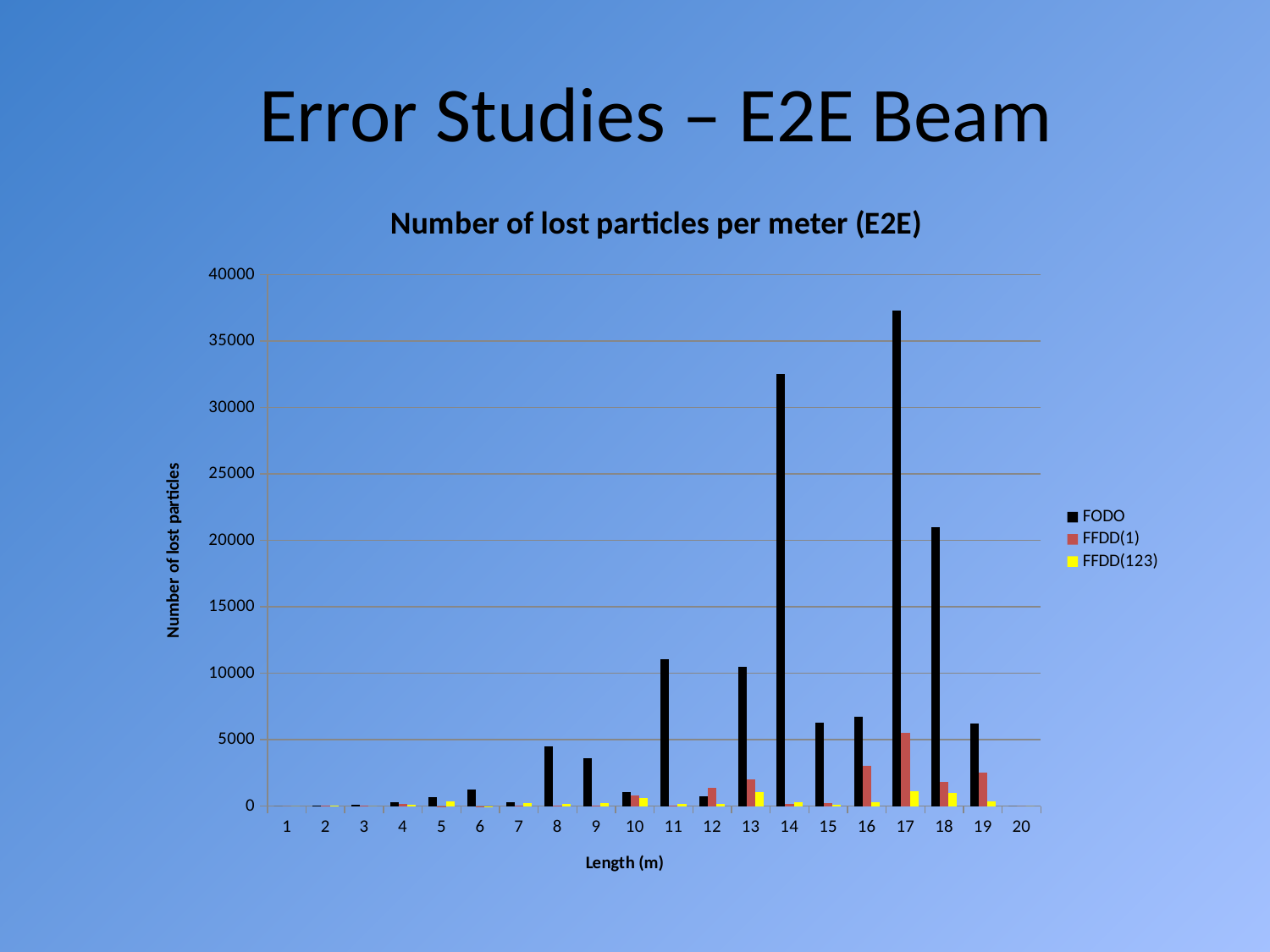
What is the title of the chart? Number of lost particles per meter (E2E) Which is larger for FFDD(1): the value at length 16 or at length 17? length 17 At which length (m) is the FODO value highest? 17 At which length (m) is the FFDD(1) value highest? 17 Which is larger for FODO: the value at length 14 or at length 18? length 14 What kind of chart is shown on the slide? bar chart How many series does the legend list? 3 How many length categories are shown on the x axis? 20 Is the FODO value at length 18 greater or less than 20000? greater Is the FODO value at length 14 greater or less than 30000? greater